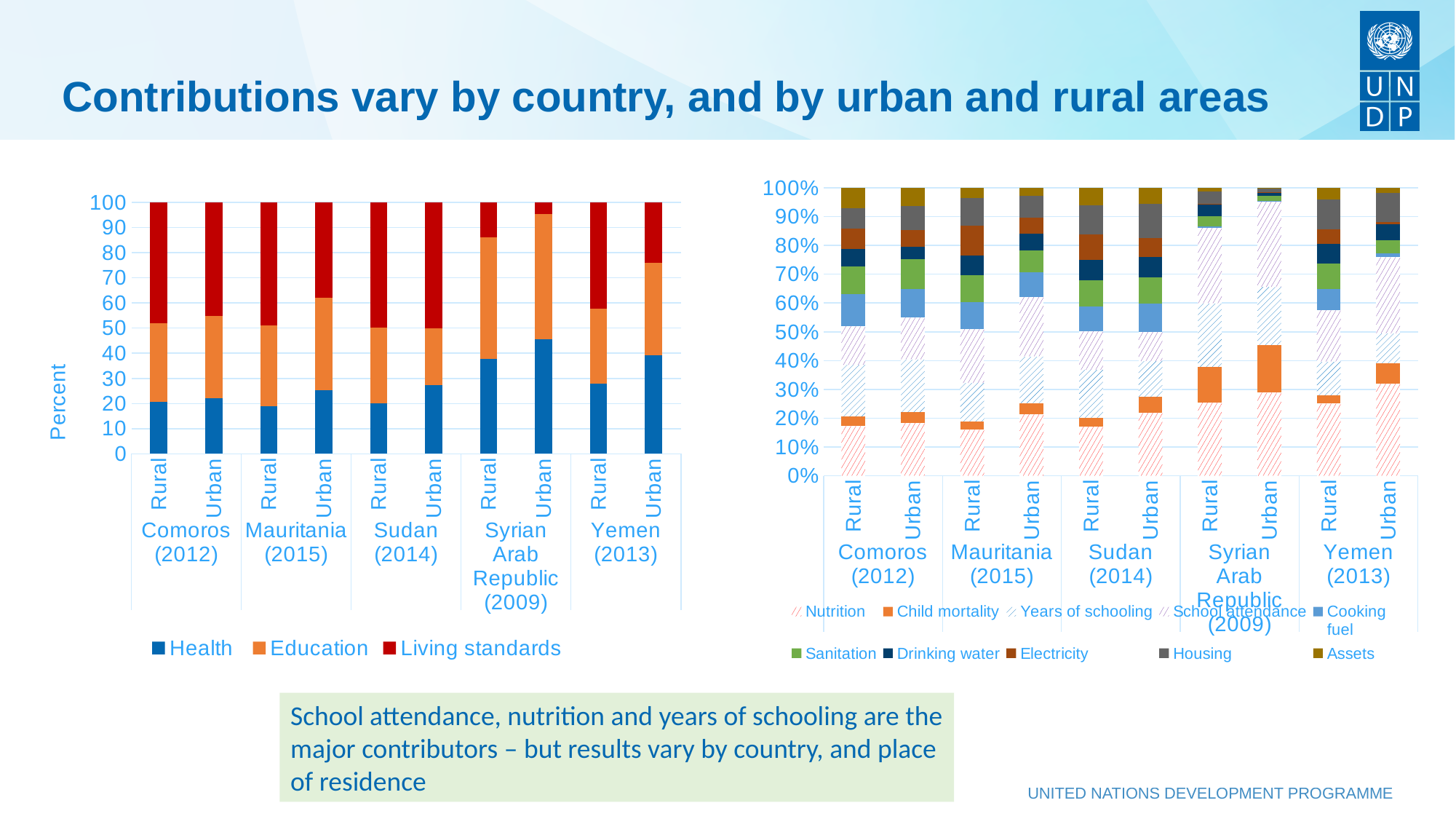
In the left chart, is the Health value for Syrian Arab Republic (2009) Urban greater or less than 40? greater In the left chart, is the Health value for Comoros (2012) Rural greater or less than 30? less What type of chart is the left chart on the slide? bar chart In the left chart, which is larger: the Health segment for Syrian Arab Republic (2009) Urban or for Comoros (2012) Rural? Syrian Arab Republic (2009) Urban What is the label on the vertical axis of the left chart? Percent In the left chart, which bar has the largest Health segment? Syrian Arab Republic (2009) Urban In the right chart, which bar has the largest Child mortality segment? Syrian Arab Republic (2009) Urban How many series does the legend of the left chart list? 3 In the left chart, what is the total height of the stacked bar for Comoros (2012) Rural? 100 How many stacked bars are plotted in the left chart? 10 In the left chart, which bar has the smallest Living standards segment? Syrian Arab Republic (2009) Urban How many series does the legend of the right chart list? 10